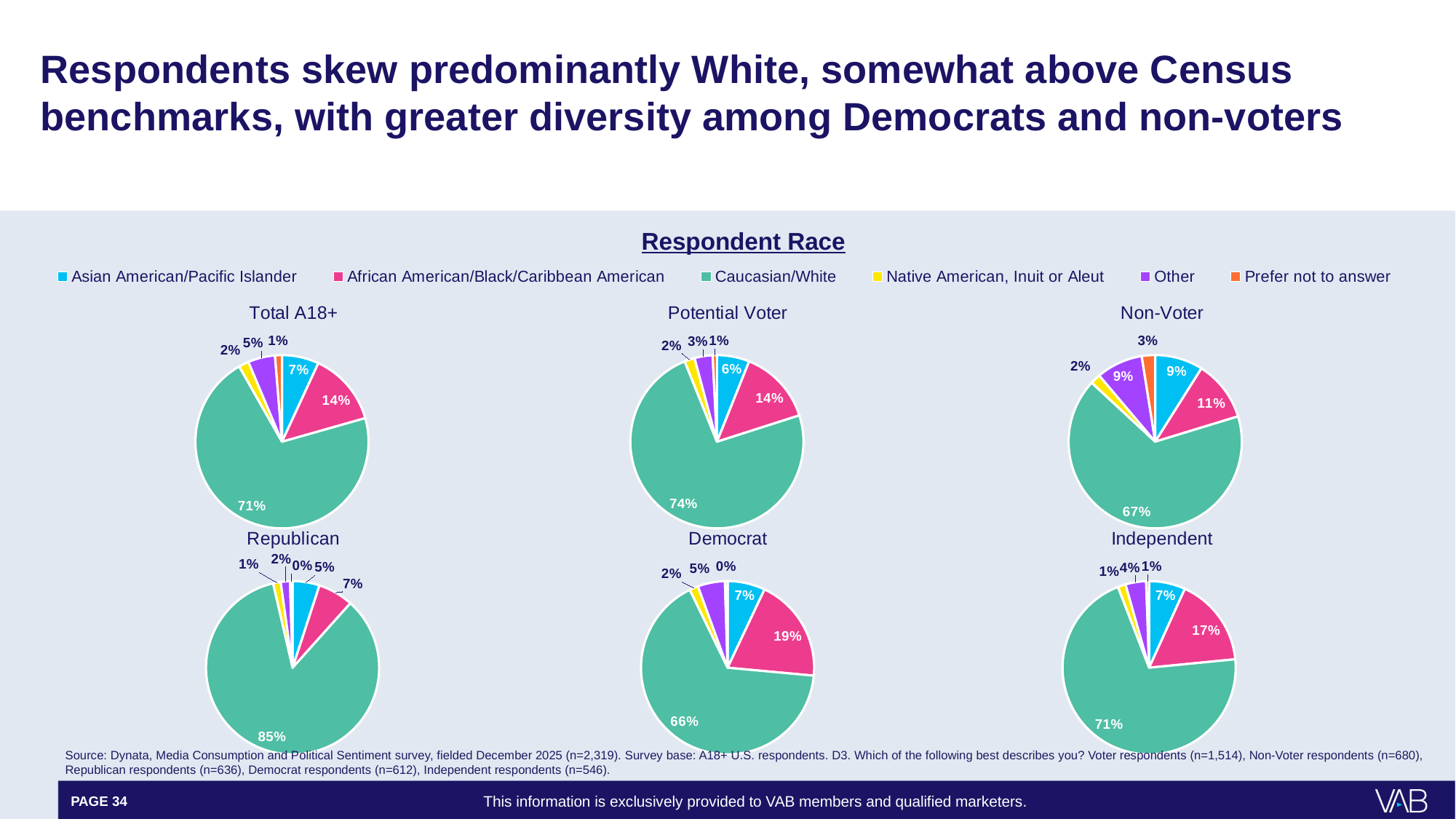
What type of chart is used to show Respondent Race on this slide? Pie chart In the Total A18+ pie chart, what share of respondents are Caucasian/White? 71% Is the African American/Black/Caribbean American share larger in the Democrat chart or the Republican chart? Democrat In the Democrat pie chart, what share of respondents are African American/Black/Caribbean American? 19% In the Republican pie chart, what share of respondents are Caucasian/White? 85% In the Potential Voter pie chart, which race category has the largest share? Caucasian/White Which of the six pie charts shows the lowest Caucasian/White share? Democrat What is the difference between the Caucasian/White share in the Potential Voter chart and in the Non-Voter chart? 7% In the Non-Voter pie chart, what share of respondents are Asian American/Pacific Islander? 9% How many series does the legend list for the Respondent Race charts? 6 Which of the six pie charts shows the highest Caucasian/White share? Republican In the Independent pie chart, what share of respondents are African American/Black/Caribbean American? 17%